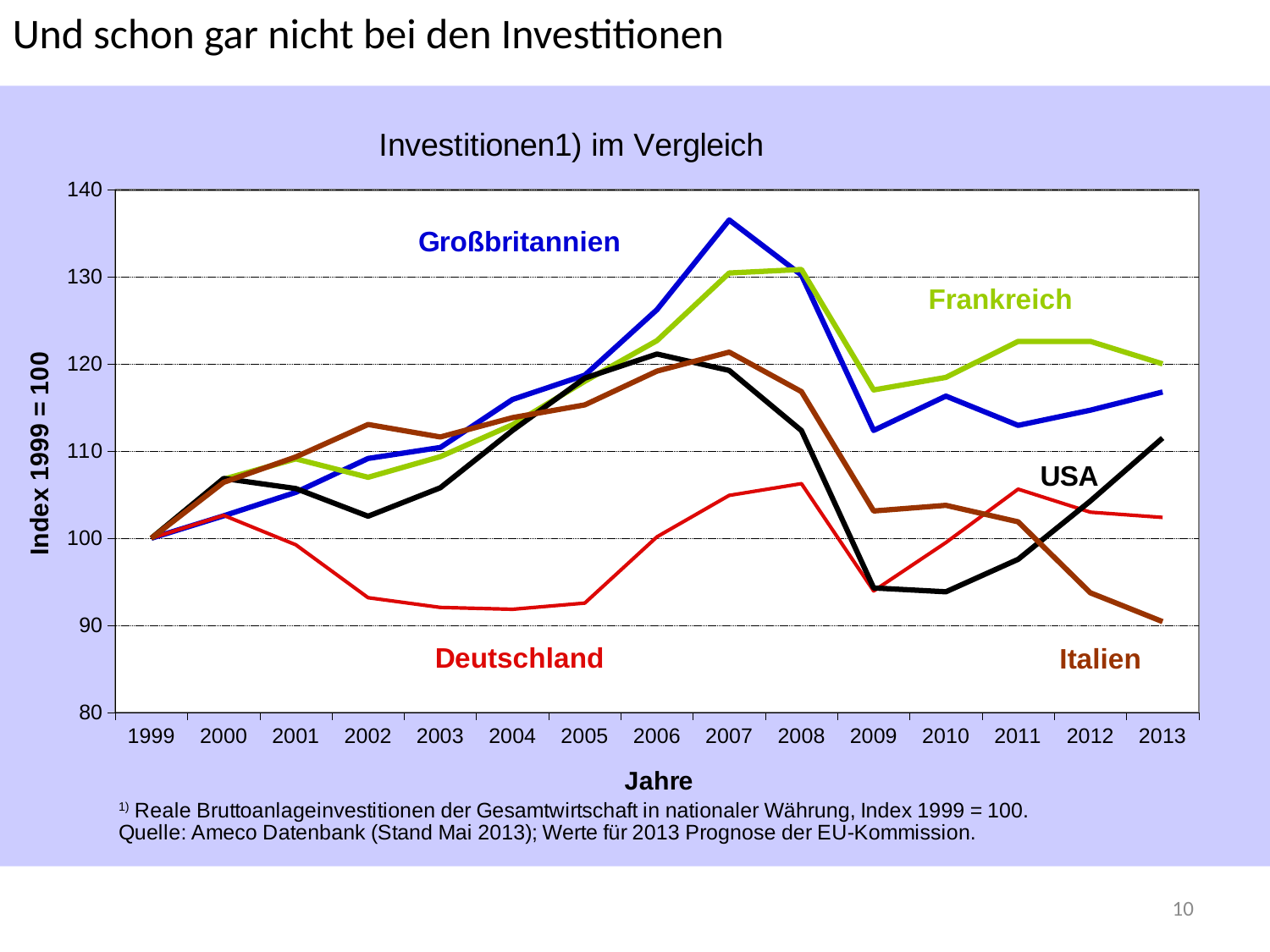
Which country has the highest value in 2007? Großbritannien Is the value for Großbritannien in 2007 greater or less than 130? greater What type of chart is shown on the slide? Line chart Which country has the lowest value in 2002? Deutschland Does the value for Italien rise or fall from 2011 to 2013? Fall How many years are shown on the x axis? 15 What is the index value for all countries in 1999? 100 How many countries are plotted in the chart? 5 Is the value for Frankreich in 2011 greater or less than 120? greater Is the value for Italien in 2013 greater or less than 100? less Which country has the lowest value in 2013? Italien In 2013, which is higher: Frankreich or Großbritannien? Frankreich